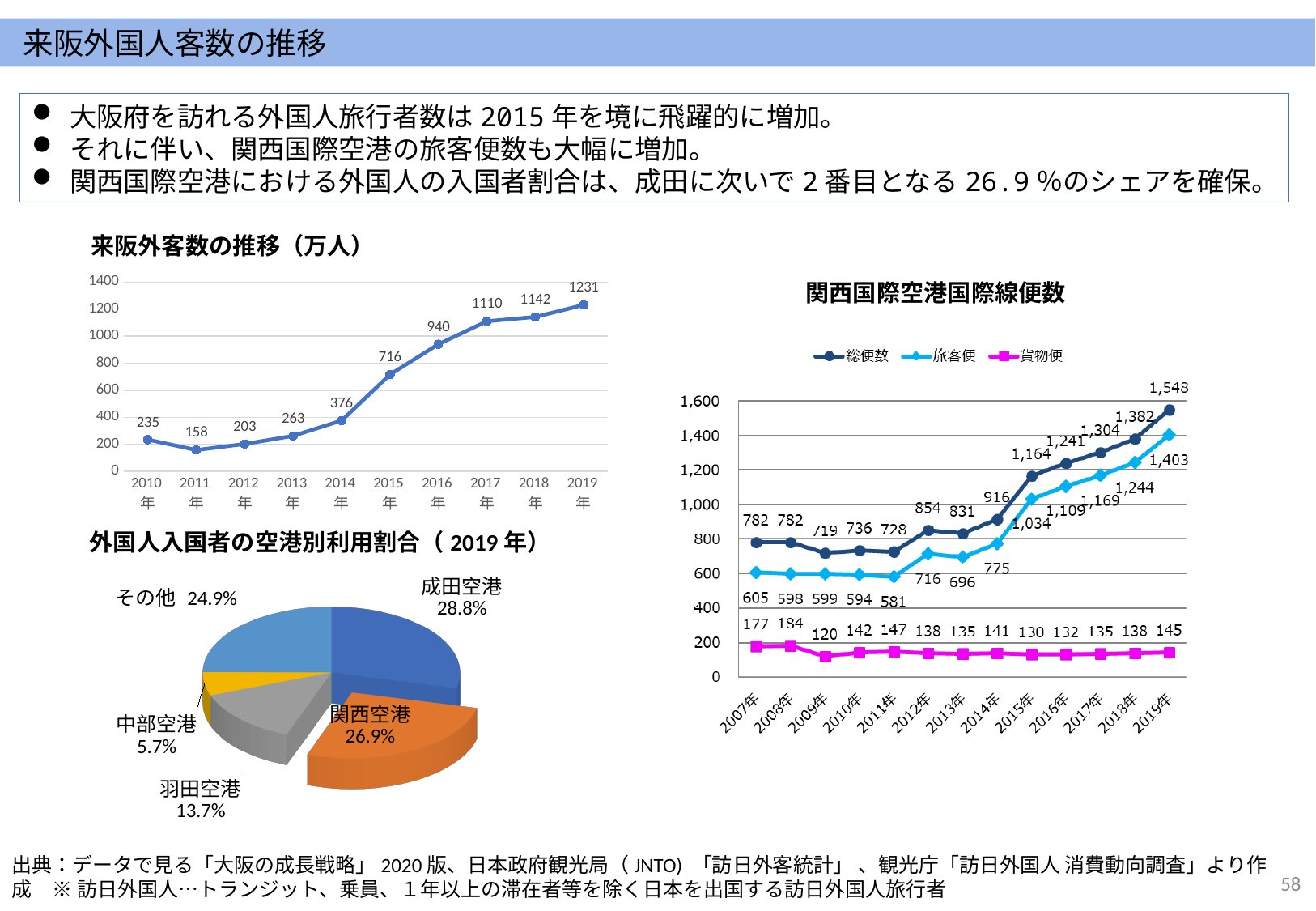
In the chart titled 関西国際空港国際線便数, what is the value of 旅客便 for 2019年? 1,403 In the chart titled 来阪外客数の推移（万人）, how many years are plotted? 10 In the chart titled 来阪外客数の推移（万人）, do the values generally rise or fall from 2014年 to 2019年? rise In the pie chart titled 外国人入国者の空港別利用割合（2019年）, how many slices are there? 5 In the pie chart titled 外国人入国者の空港別利用割合（2019年）, what share does 羽田空港 have? 13.7% In the chart titled 関西国際空港国際線便数, what is the difference between 総便数 and 旅客便 in 2015年? 130 In the pie chart titled 外国人入国者の空港別利用割合（2019年）, which airport has the largest share? 成田空港 In the chart titled 来阪外客数の推移（万人）, which year has the lowest value? 2011年 In the chart titled 来阪外客数の推移（万人）, what is the difference between the values for 2019年 and 2010年? 996 In the chart titled 来阪外客数の推移（万人）, what is the value for 2015年? 716 What kind of chart is the chart titled 関西国際空港国際線便数? line chart In the chart titled 関西国際空港国際線便数, how many series does the legend list? 3